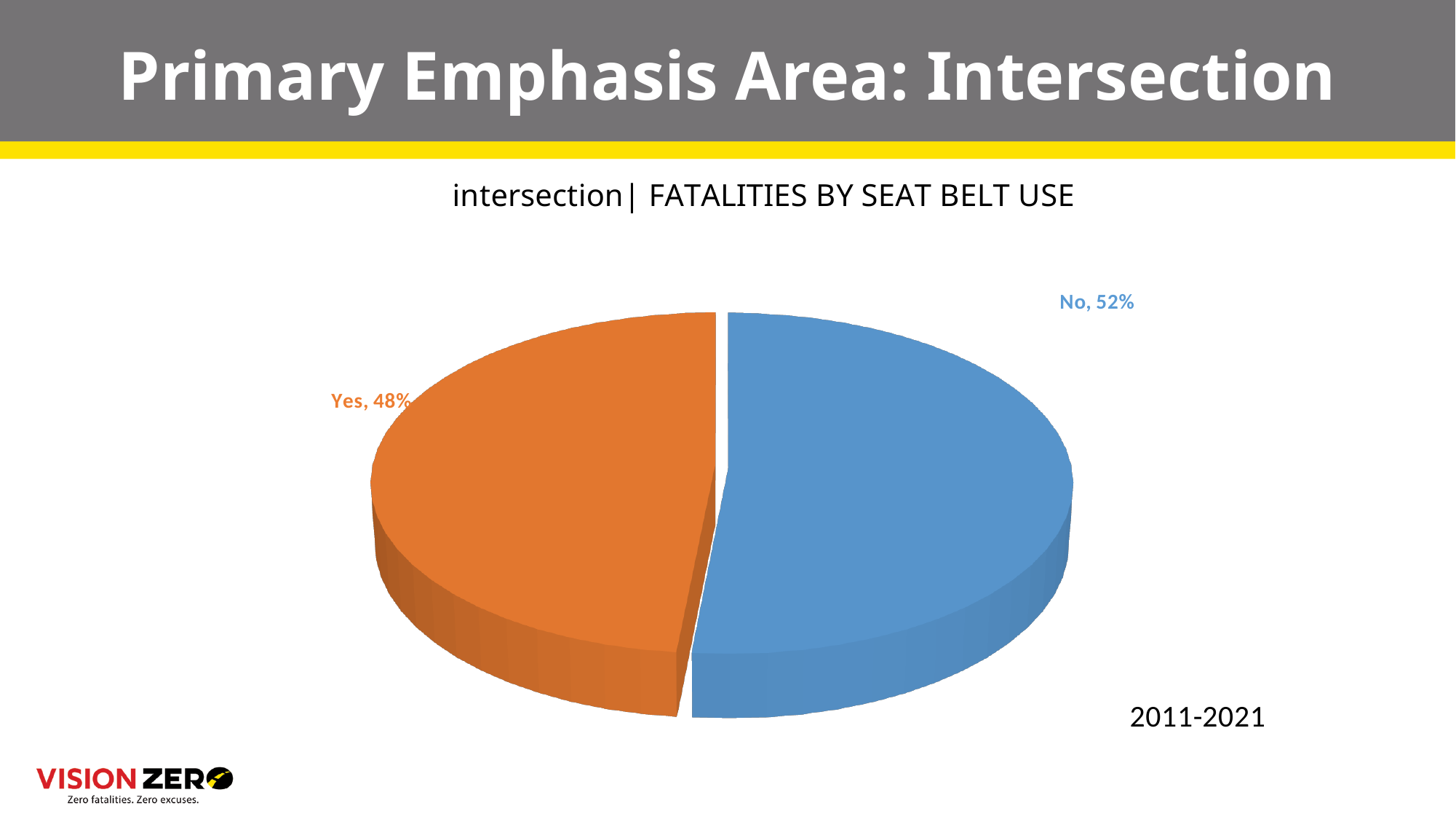
What colour is the "Yes" slice of the pie? orange What is the difference in percentage points between the "No" and "Yes" slices? 4 How many slices does the pie chart have? 2 Which category has the largest share of the pie? No What is the title of the chart? intersection| FATALITIES BY SEAT BELT USE Which slice of the pie is larger, "Yes" or "No"? No What kind of chart is shown on the slide? pie chart What share of intersection fatalities is labelled "No" for seat belt use? 52% What share of intersection fatalities is labelled "Yes" for seat belt use? 48% What time period does the chart cover, as printed on the slide? 2011-2021 Which category has the smallest share of the pie? Yes